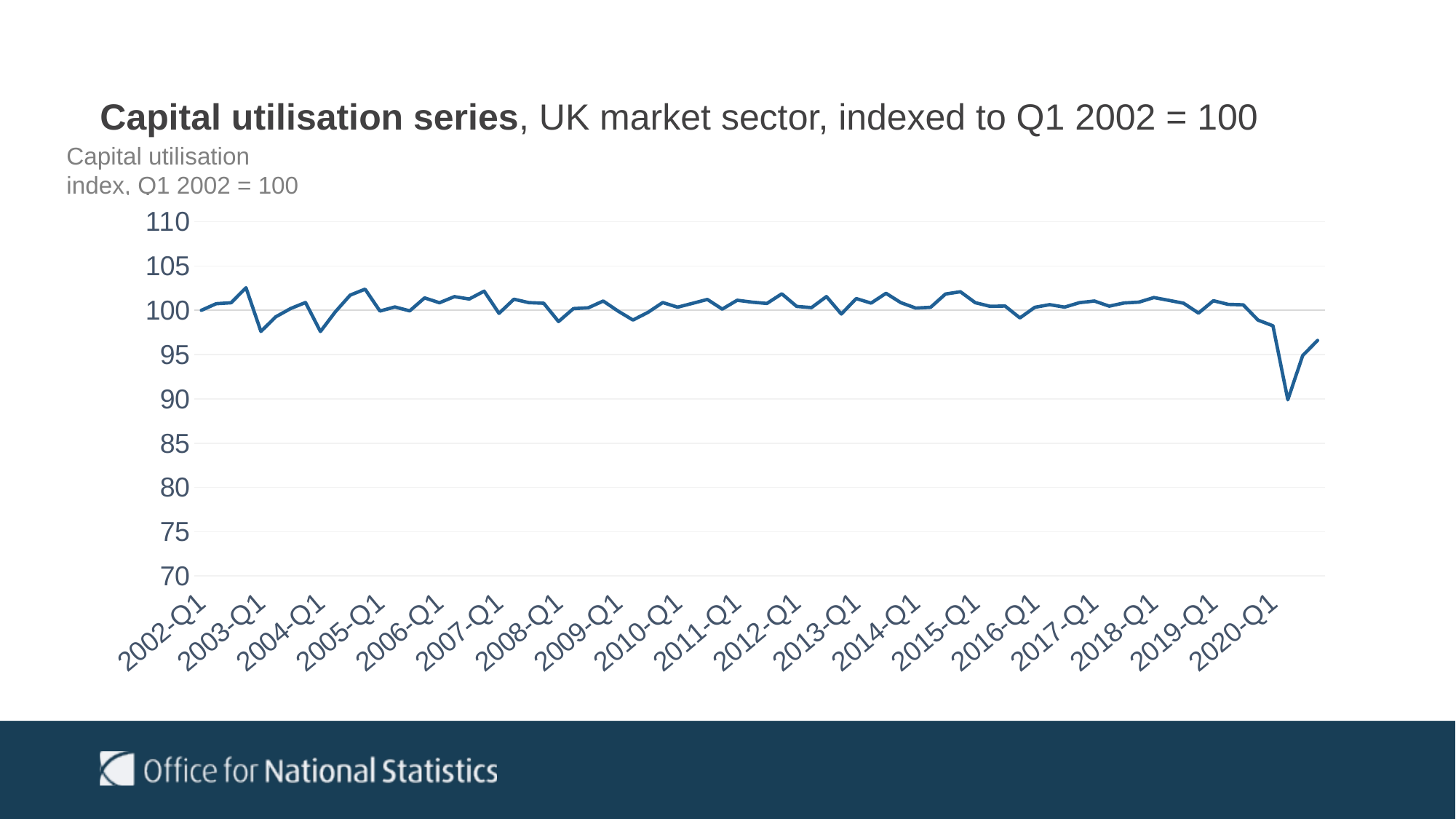
What is the title of the chart? Capital utilisation series, UK market sector, indexed to Q1 2002 = 100 What kind of chart is shown on the slide? Line chart Between 2019-Q1 and the lowest point in 2020, does the series rise or fall? fall Is the value for 2020-Q1 greater or less than 95? greater What is the label on the vertical axis of the chart? Capital utilisation index, Q1 2002 = 100 Is the lowest value of the series greater or less than 95? less How many series are plotted on the chart? 1 In which year does the series reach its lowest point? 2020 Is the lowest value of the series greater or less than 85? greater How many year labels are shown on the x axis? 19 What is the value of the capital utilisation index at 2002-Q1? 100